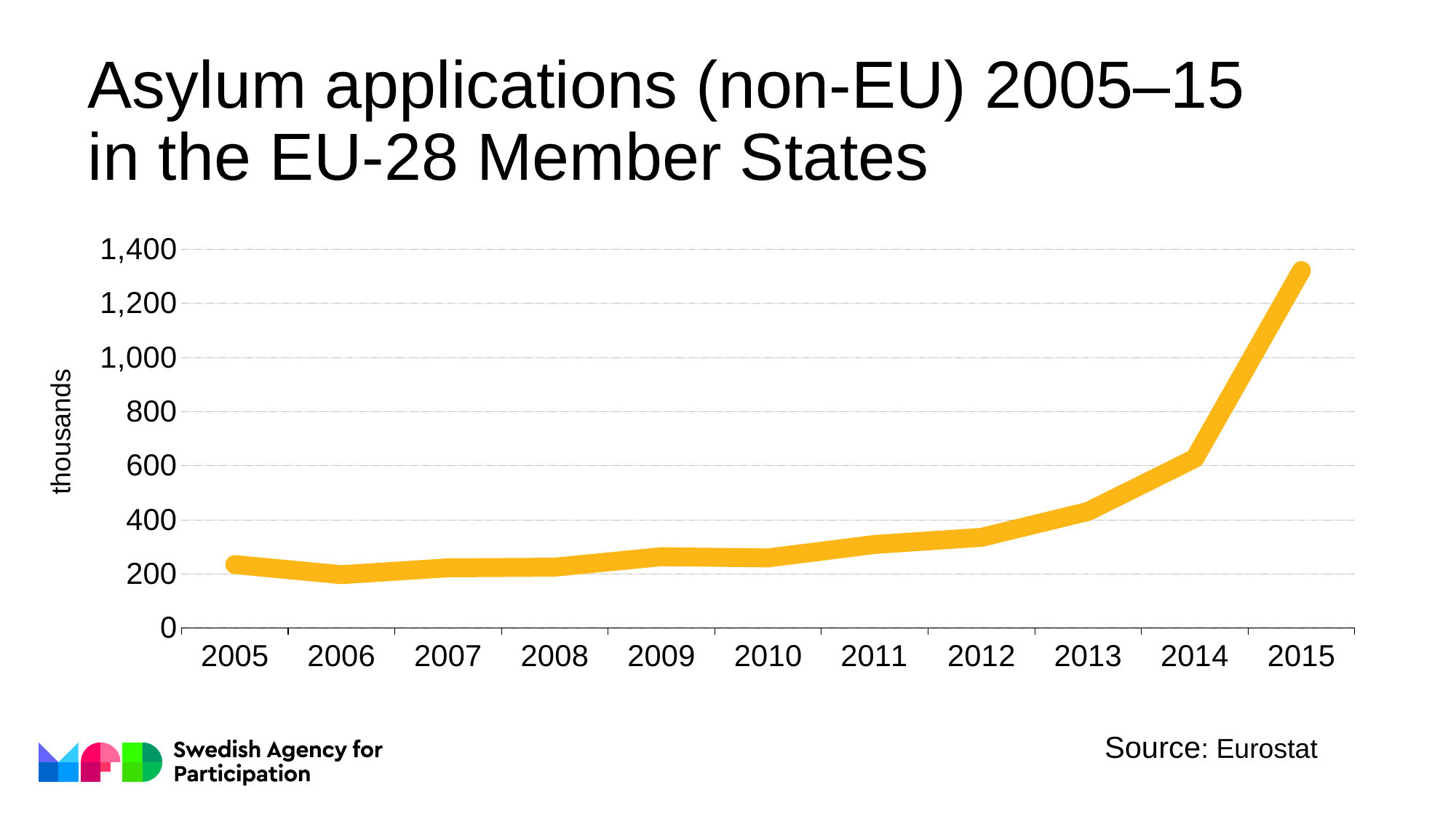
Is the value for 2011 greater or less than 200? greater Which year has the lowest number of asylum applications? 2006 Is the value for 2012 greater or less than 400? less What kind of chart is shown on the slide? line chart Which year has the highest number of asylum applications? 2015 What unit is given on the y axis label? thousands Is the value for 2013 greater or less than 600? less Which year has the larger value, 2005 or 2015? 2015 How many years are plotted along the x axis? 11 Do the values generally rise or fall from 2010 to 2015? rise